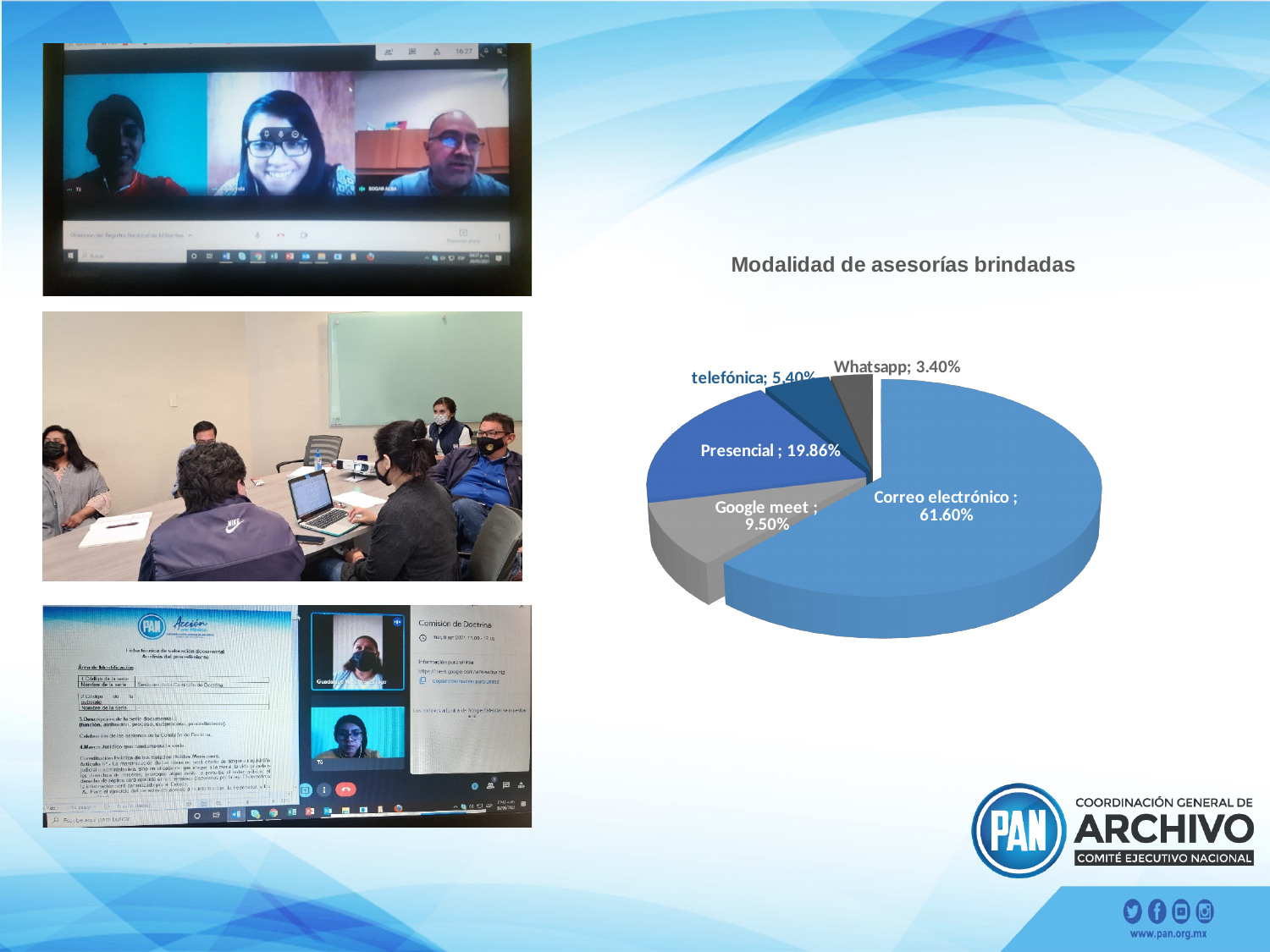
What percentage of the pie chart is Presencial? 19.86% Which is larger in the pie chart, Google meet or telefónica? Google meet What percentage of the pie chart is Google meet? 9.50% Which category has the largest share of the pie chart? Correo electrónico Which category has the smallest share of the pie chart? Whatsapp How many slices does the pie chart have? 5 What is the title of the pie chart? Modalidad de asesorías brindadas What percentage of the pie chart is Whatsapp? 3.40% What percentage of the pie chart is Correo electrónico? 61.60% What is the difference in percentage points between Correo electrónico and Presencial? 41.74 What kind of chart is shown on the slide? pie chart What percentage of the pie chart is telefónica? 5.40%